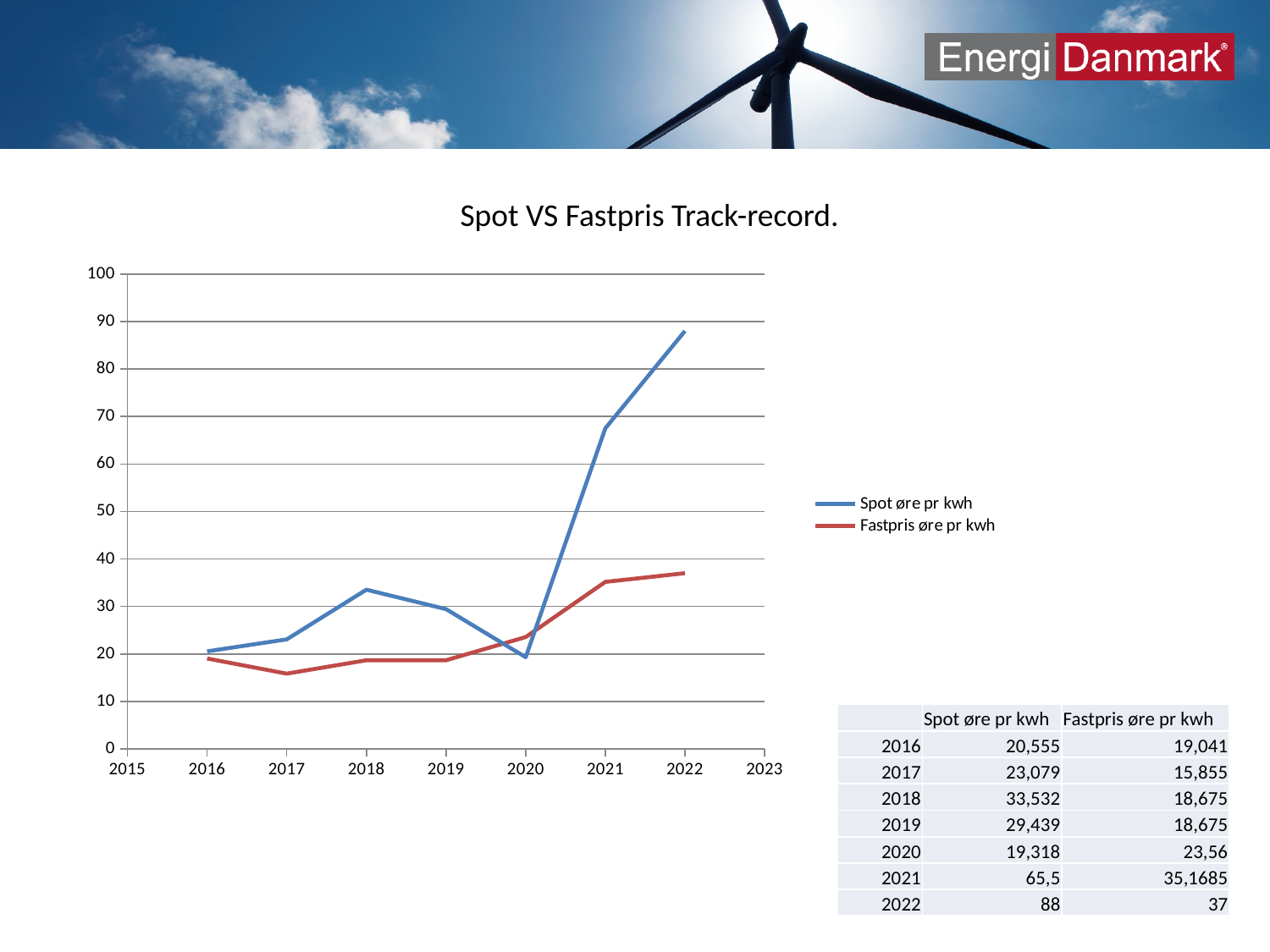
In which year is Fastpris øre pr kwh lowest? 2017 What is the Spot øre pr kwh value for 2022? 88 How many series does the legend list? 2 Is the Spot øre pr kwh value for 2021 greater or less than 60? greater What is the title of the chart? Spot VS Fastpris Track-record. What is the Fastpris øre pr kwh value for 2017? 15,855 In 2018, which is larger: Spot øre pr kwh or Fastpris øre pr kwh? Spot øre pr kwh What kind of chart is shown on the slide? line chart In which year is Spot øre pr kwh highest? 2022 How many years are plotted for each series? 7 Does Spot øre pr kwh rise or fall from 2020 to 2022? rise What is the difference between Spot øre pr kwh and Fastpris øre pr kwh in 2022? 51